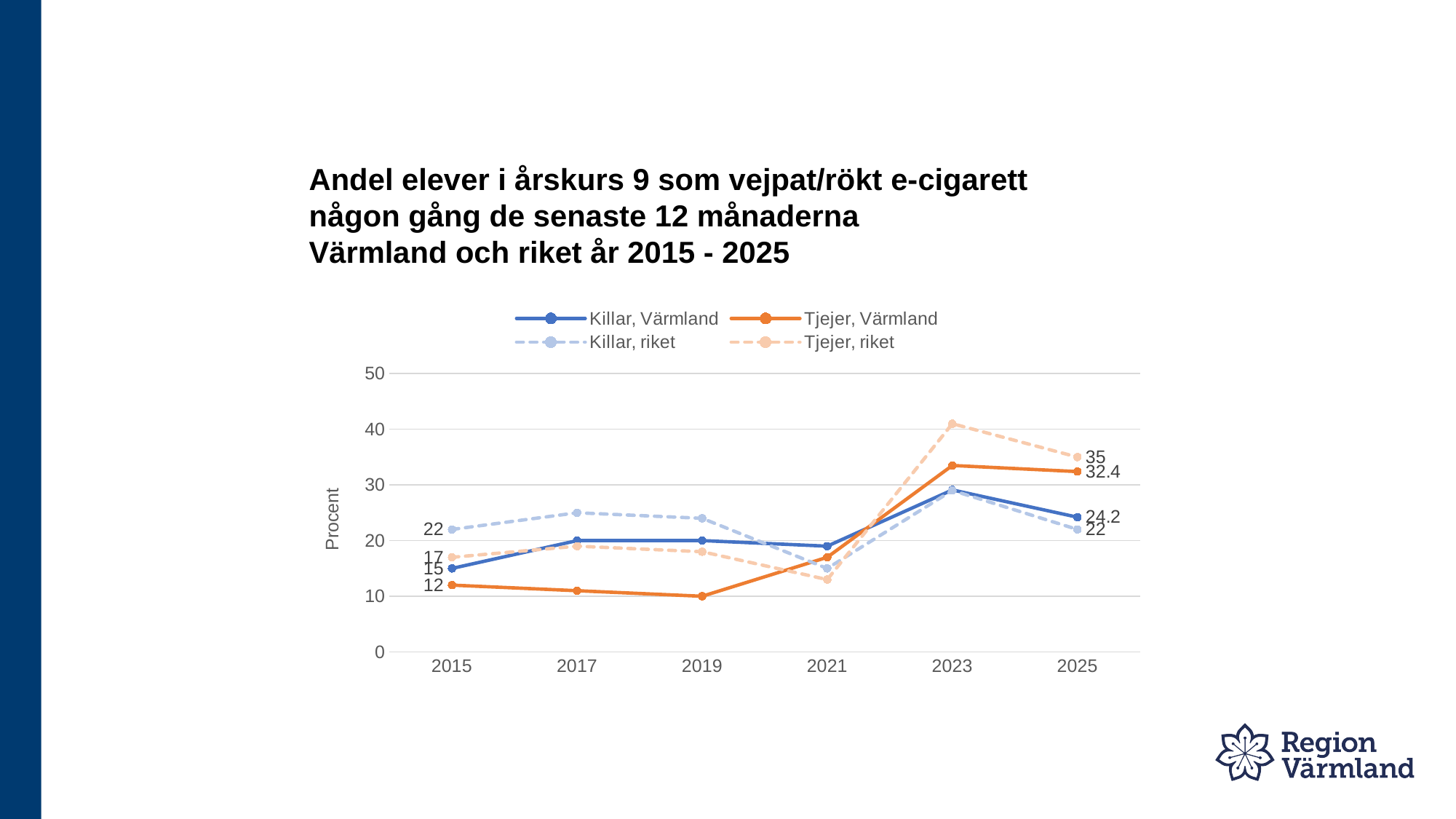
How many years are shown on the x axis? 6 What type of chart is shown on the slide? line chart What is the difference between Tjejer, Värmland in 2025 and Tjejer, Värmland in 2015? 20.4 Which series has the highest value in 2025? Tjejer, riket What is the label of the y axis? Procent Which series has the lowest value in 2015? Tjejer, Värmland Is the value for Tjejer, riket in 2023 greater or less than 40? greater What is the value for Tjejer, Värmland in 2025? 32.4 What is the value for Tjejer, riket in 2025? 35 What is the value for Killar, riket in 2015? 22 What is the value for Killar, Värmland in 2015? 15 How many series does the legend list? 4